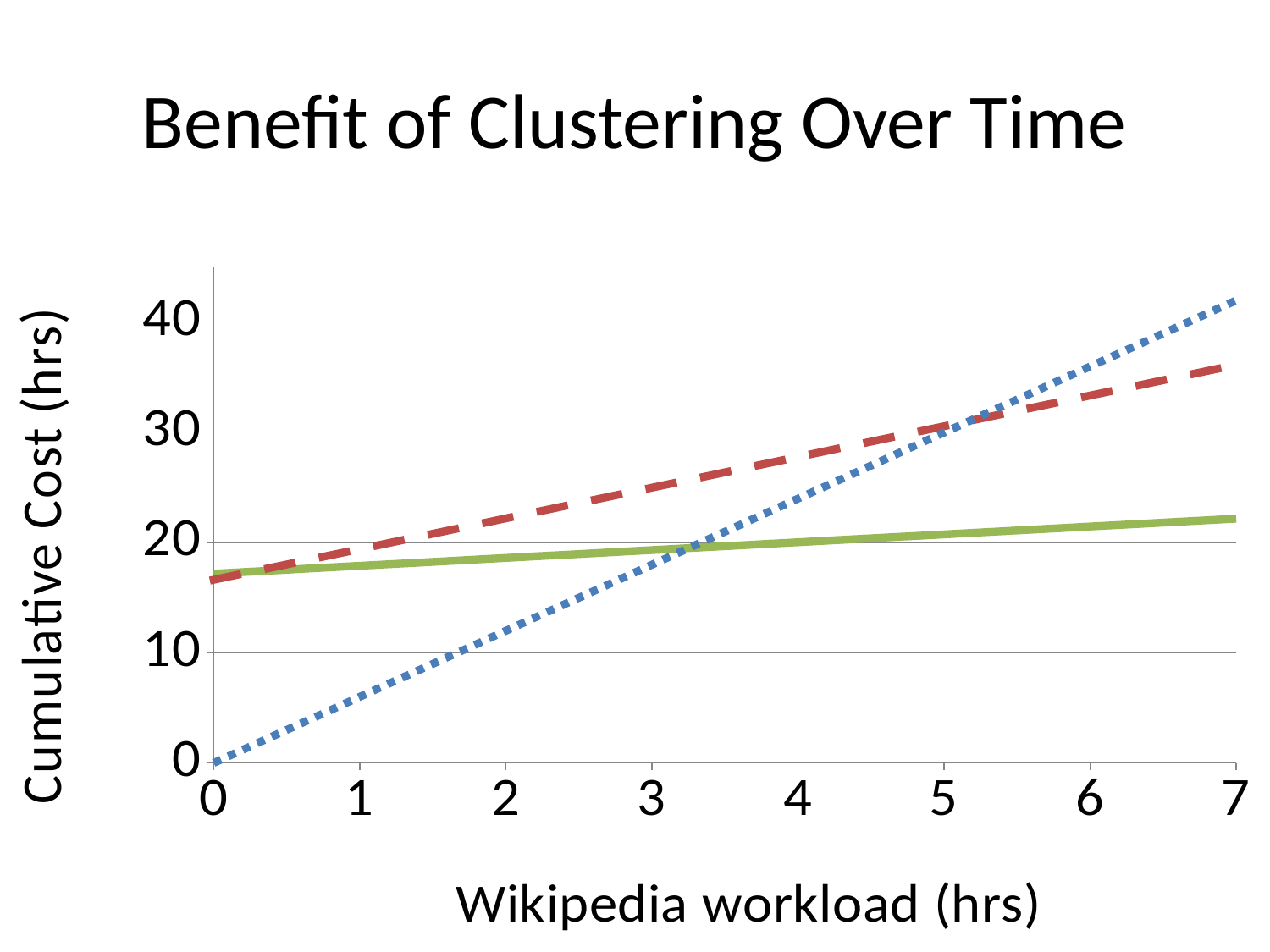
How many lines are plotted on the chart? 3 Is the value of the red dashed line at a workload of 7 hrs greater or less than 40? less What is the value of the blue dotted line at a Wikipedia workload of 0 hrs? 0 Is the value of the green solid line at a workload of 0 hrs greater or less than 20? less Does the blue dotted line rise or fall as the Wikipedia workload increases? rise What is the label of the y axis? Cumulative Cost (hrs) Which line has the highest cumulative cost at a workload of 7 hrs? the blue dotted line What kind of chart is shown on the slide? line chart Is the value of the blue dotted line at a workload of 1 hr greater or less than 10? less What is the title of the chart? Benefit of Clustering Over Time At a workload of 7 hrs, which is higher: the red dashed line or the green solid line? the red dashed line